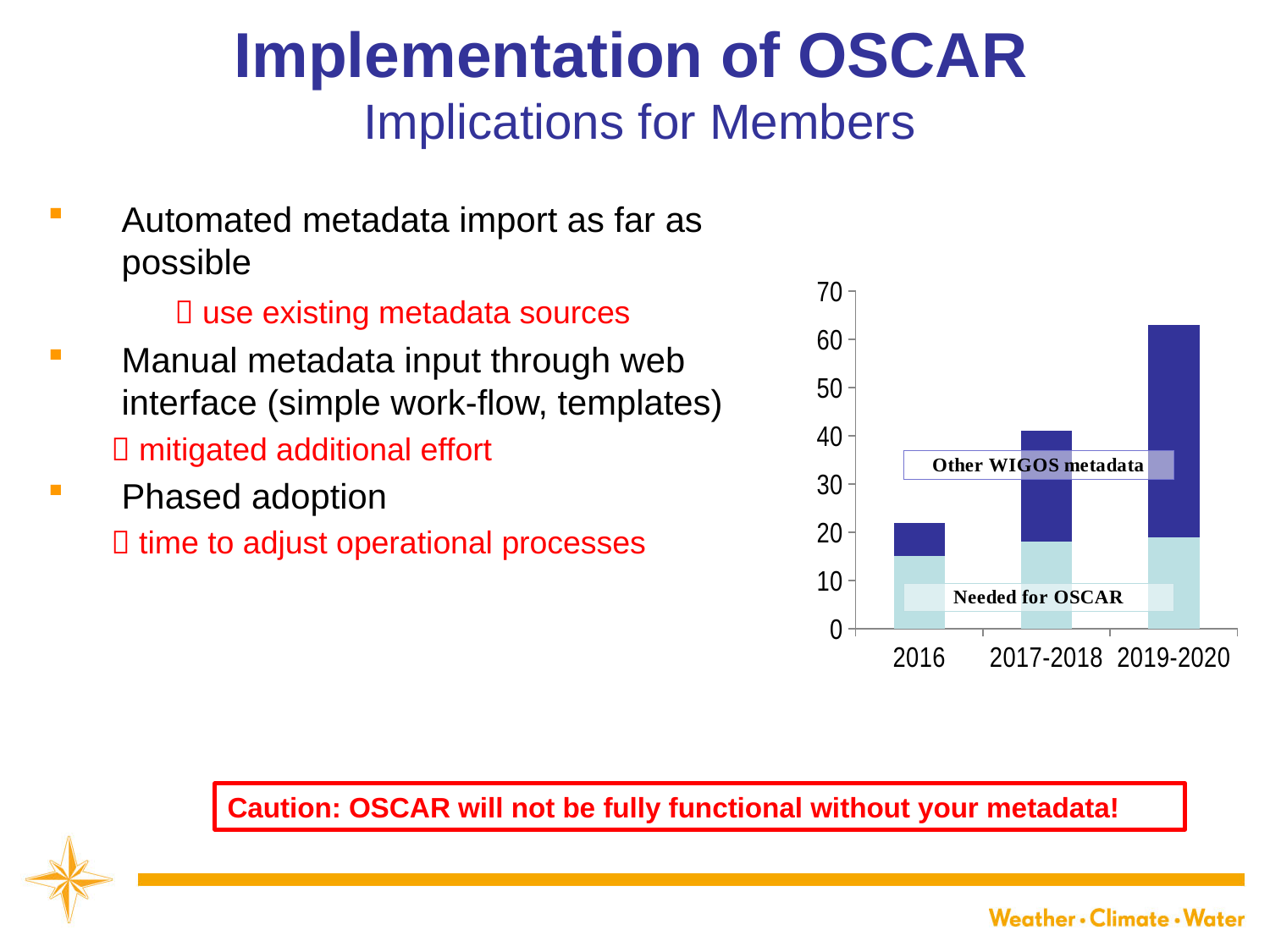
Which category has the tallest stacked bar in the chart? 2019-2020 How many series does the chart show? 2 What does the dark blue segment of each bar represent? Other WIGOS metadata Is the total bar height for 2019-2020 greater or less than 50? greater Do the total bar heights rise or fall from 2016 to 2019-2020? rise Is the total bar height for 2017-2018 greater or less than 50? less Is the total bar height for 2016 greater or less than 30? less Which category has the shortest stacked bar in the chart? 2016 How many categories are shown on the x axis of the chart? 3 What kind of chart is shown on the slide? Stacked bar chart Which has the larger total bar, 2016 or 2019-2020? 2019-2020